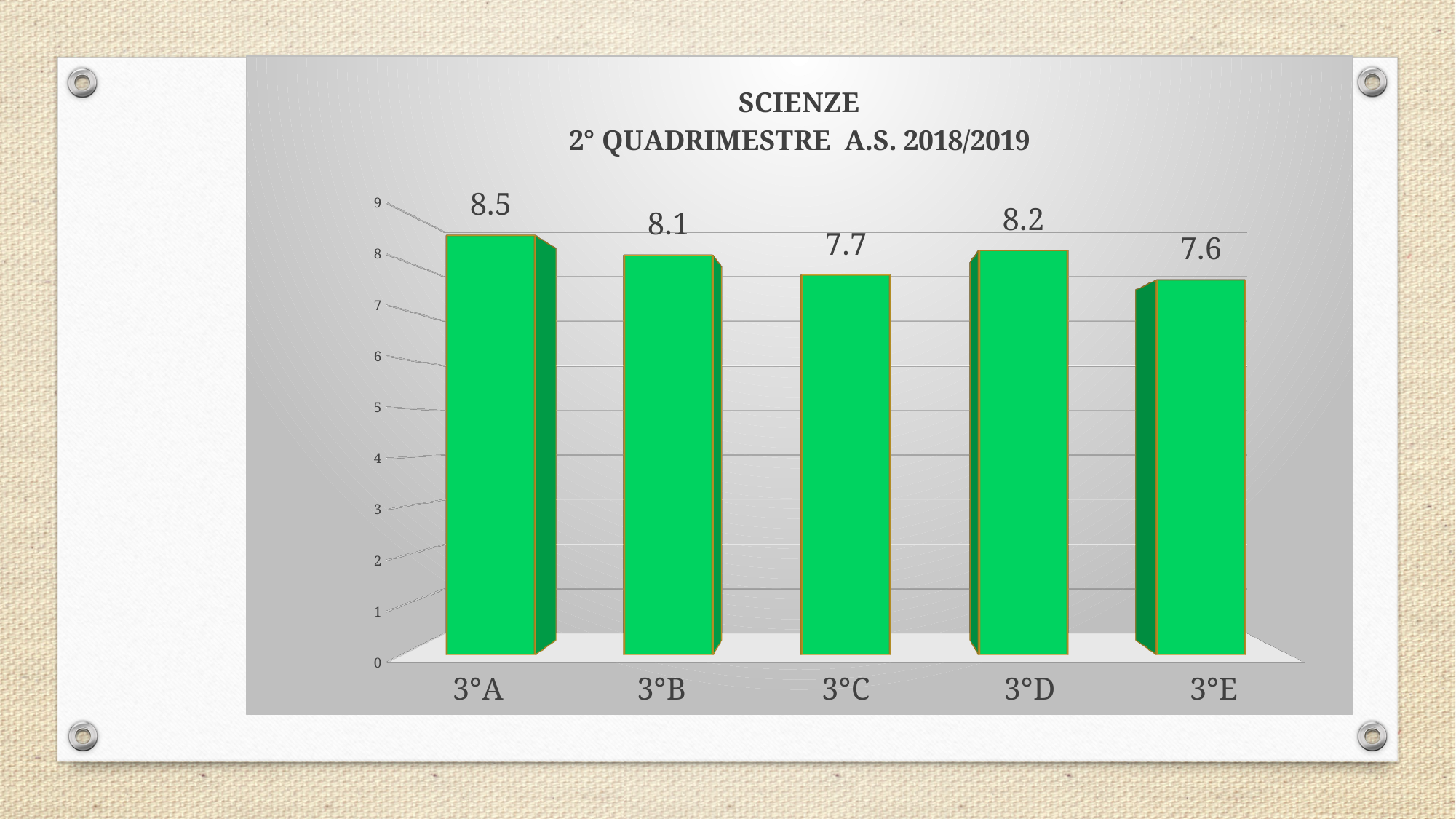
What is the title of the chart? SCIENZE 2° QUADRIMESTRE A.S. 2018/2019 Which is larger, the value for 3°B or the value for 3°D? 3°D What is the value for 3°C? 7.7 What is the difference between the values for 3°D and 3°C? 0.5 Is the value for 3°C greater or less than 8? less Which class has the highest value? 3°A What is the difference between the values for 3°A and 3°B? 0.4 What kind of chart is shown on the slide? bar chart What is the value for 3°E? 7.6 Which class has the lowest value? 3°E How many classes are shown on the x axis? 5 What is the value for 3°A? 8.5